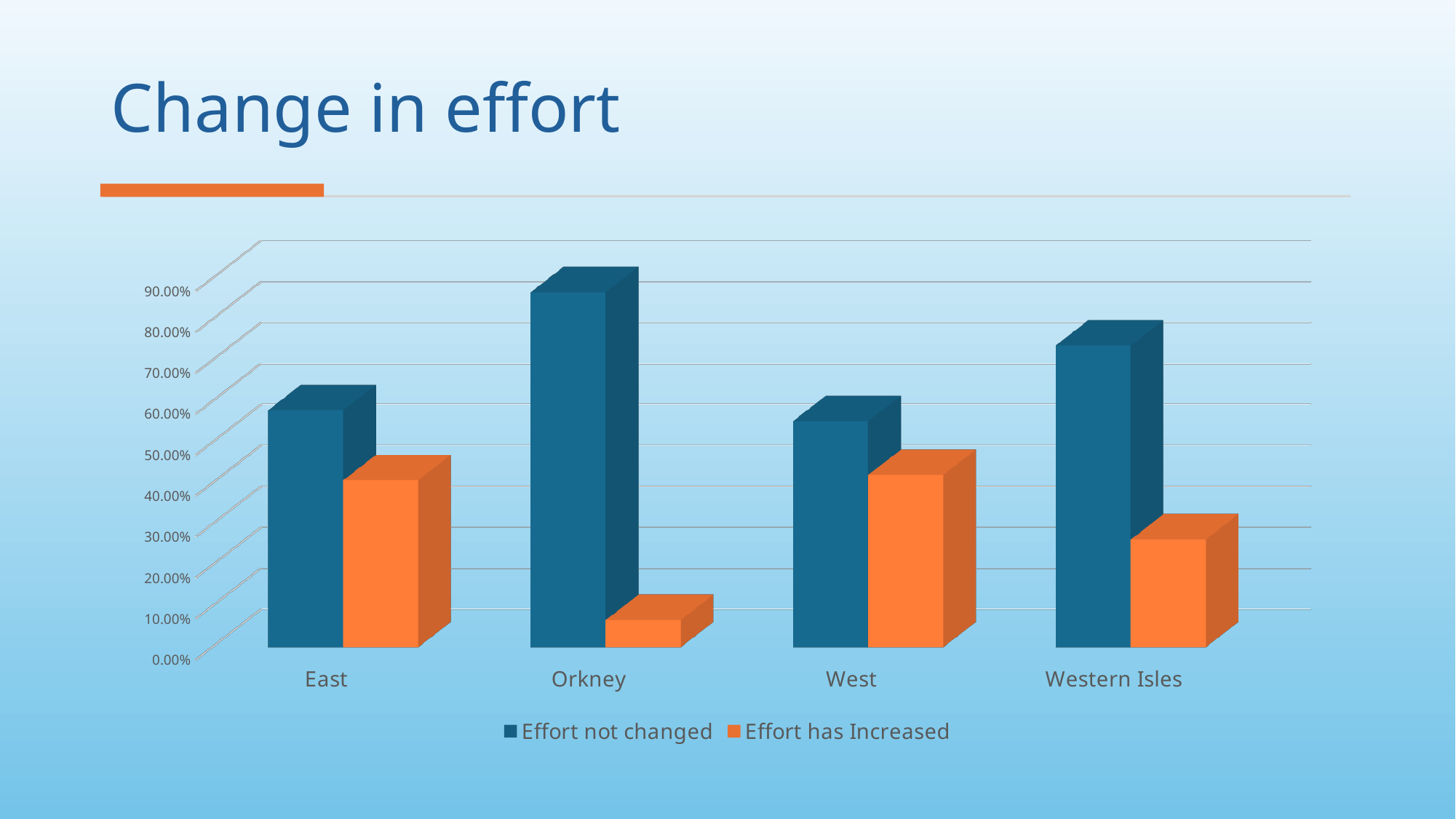
For Western Isles, which is larger: Effort not changed or Effort has Increased? Effort not changed Which category has the lowest value for Effort has Increased? Orkney What is the title of the slide containing the chart? Change in effort Is the value for Effort has Increased in Western Isles greater or less than 40.00%? less How many series does the chart's legend list? 2 How many categories are shown on the x axis of the chart? 4 What kind of chart is shown on the slide? bar chart Which category has the highest value for Effort not changed? Orkney Is the value for Effort not changed in Orkney greater or less than 80.00%? greater Is the value for Effort not changed in Western Isles greater or less than 60.00%? greater For Orkney, which is larger: Effort not changed or Effort has Increased? Effort not changed